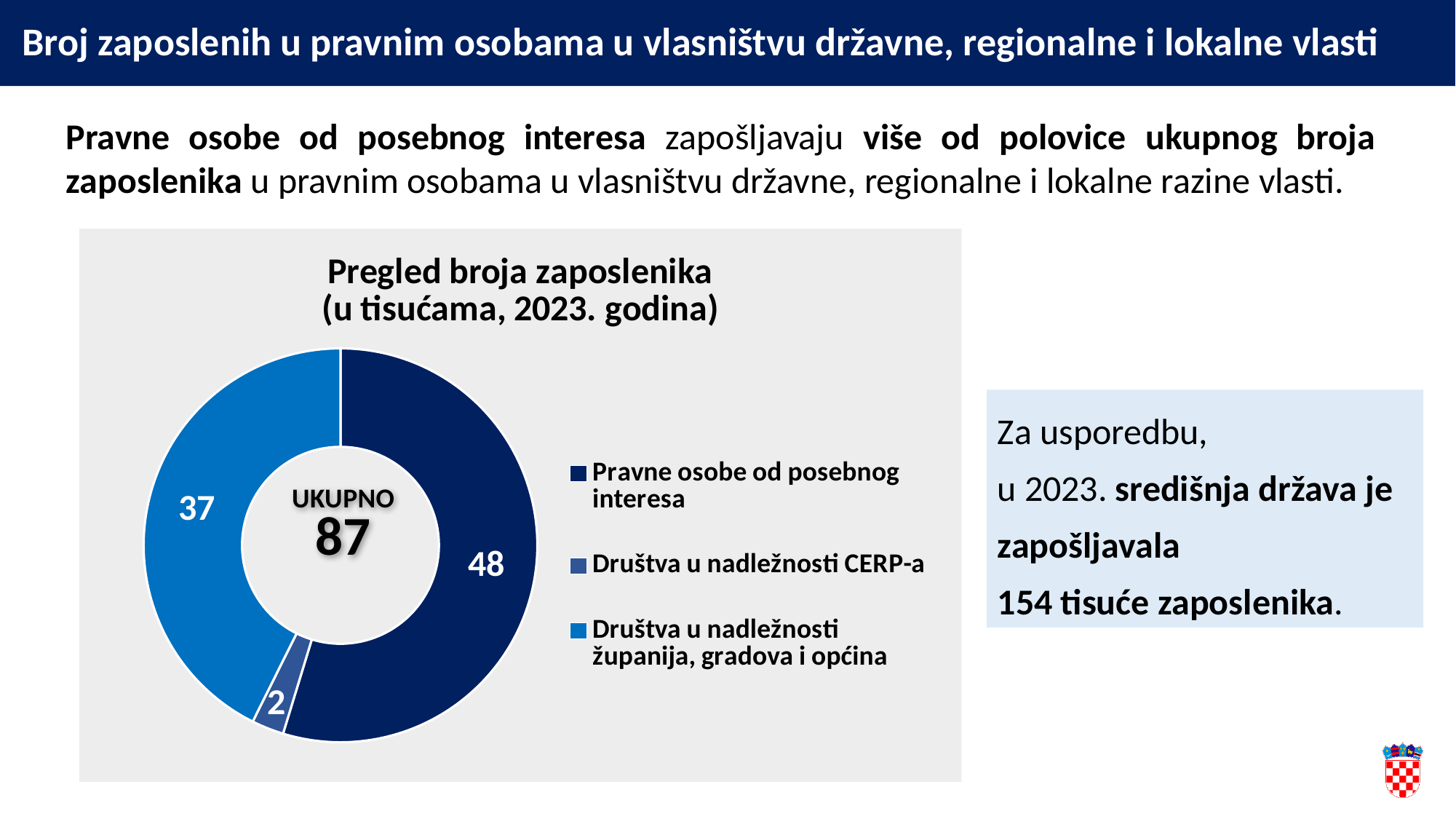
What type of chart is shown on the slide? Donut (pie) chart What is the value for 'Pravne osobe od posebnog interesa'? 48 Which category has the smallest value? Društva u nadležnosti CERP-a Which category has the largest value? Pravne osobe od posebnog interesa How many categories does the legend list? 3 What is the value for 'Društva u nadležnosti županija, gradova i općina'? 37 What is the title of the chart? Pregled broja zaposlenika (u tisućama, 2023. godina) What total is shown in the centre of the donut chart? 87 What is the difference between the values for 'Pravne osobe od posebnog interesa' and 'Društva u nadležnosti županija, gradova i općina'? 11 Which is larger: 'Društva u nadležnosti županija, gradova i općina' or 'Društva u nadležnosti CERP-a'? Društva u nadležnosti županija, gradova i općina What is the value for 'Društva u nadležnosti CERP-a'? 2